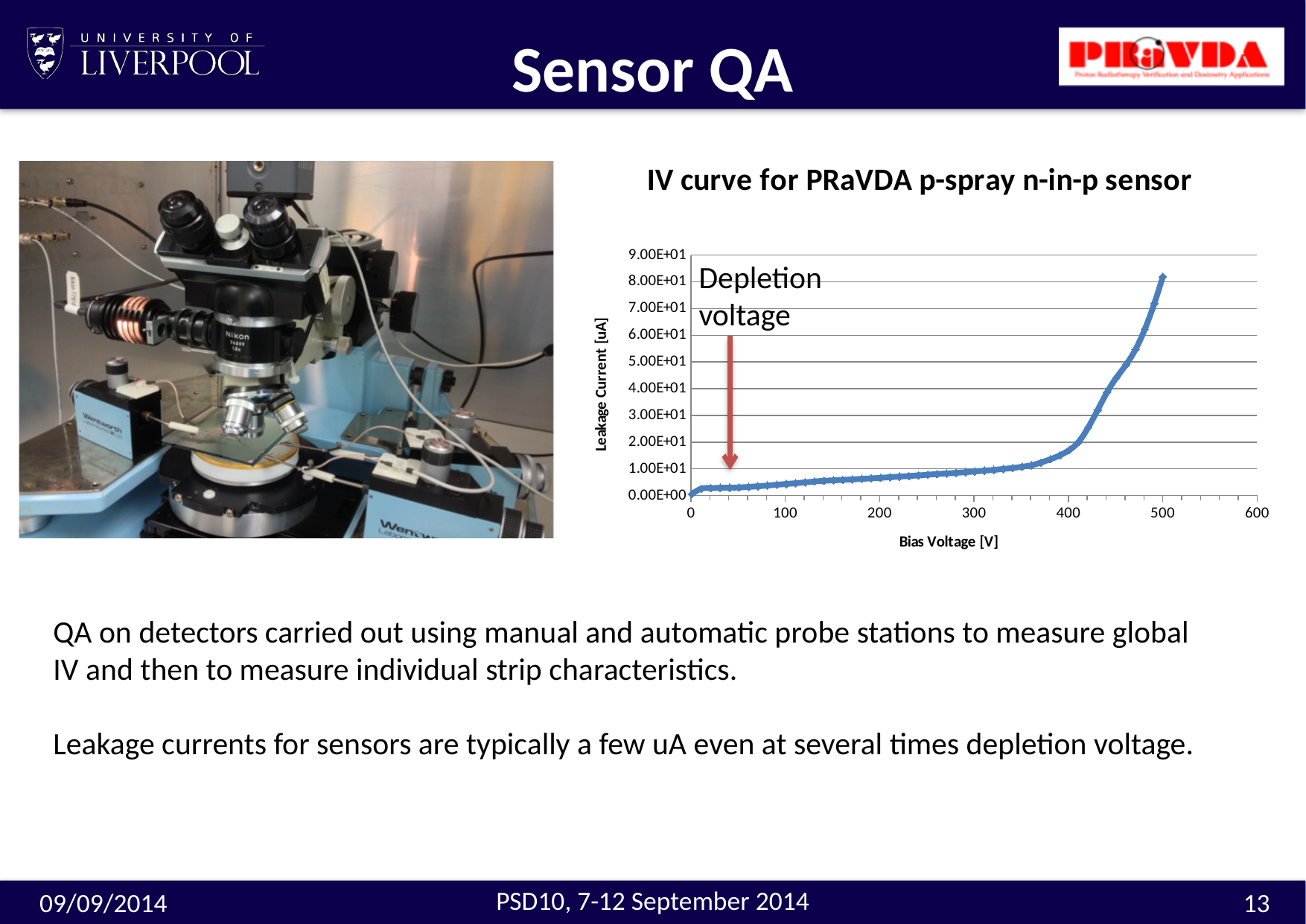
At which end of the bias voltage range, 0 V or 500 V, is the leakage current higher? 500 V What is the label of the x axis of the chart? Bias Voltage [V] What kind of chart is shown on the slide? line chart Is the leakage current at a bias voltage of 500 V greater or less than 7.00E+01 uA? greater Is the leakage current at a bias voltage of 450 V greater or less than 2.00E+01 uA? greater What is the title of the chart? IV curve for PRaVDA p-spray n-in-p sensor What is the highest tick value shown on the y axis of the chart? 9.00E+01 Is the leakage current at a bias voltage of 400 V greater or less than 3.00E+01 uA? less Does the leakage current rise or fall as the bias voltage increases along the x axis? rise